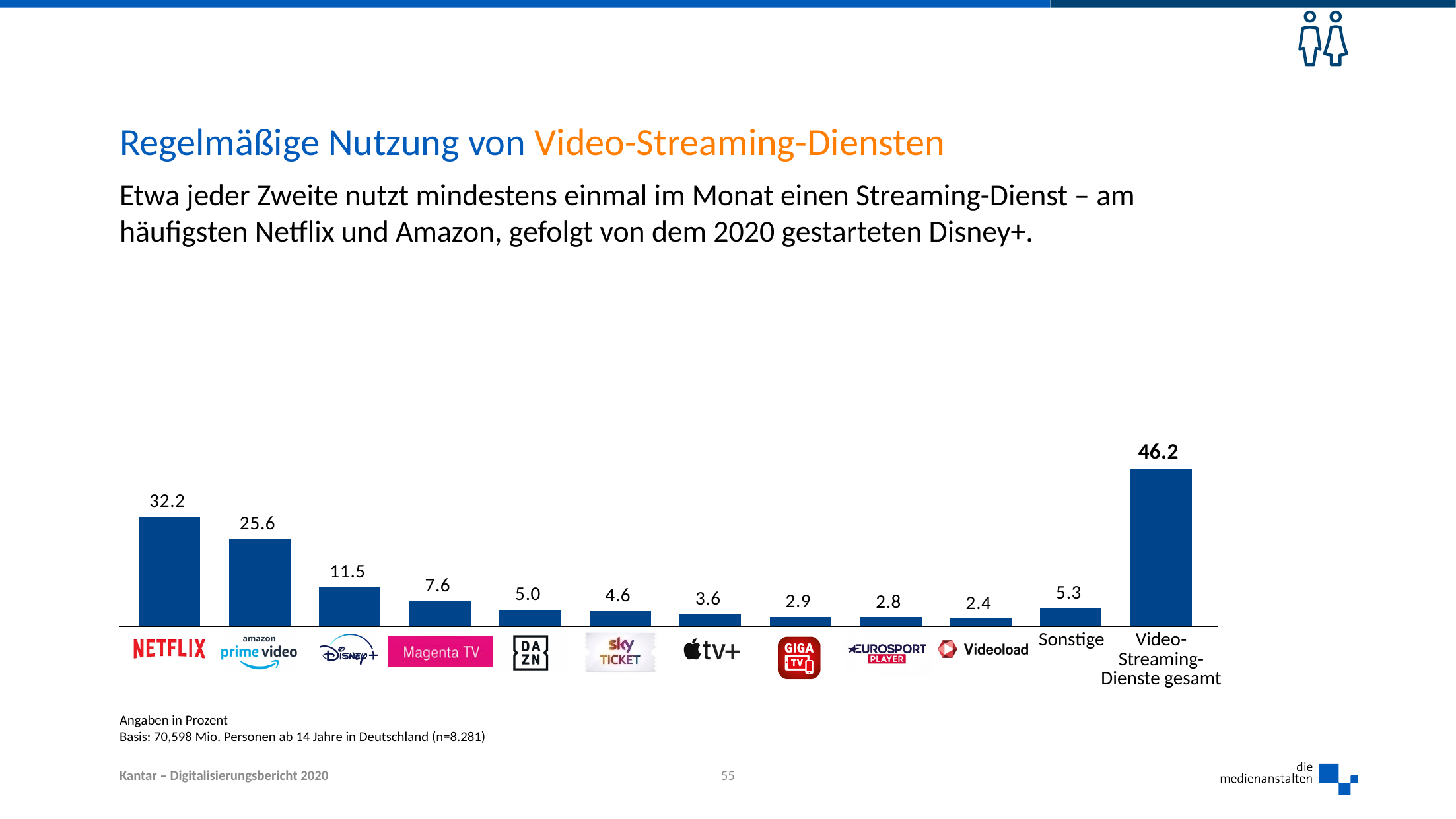
What kind of chart is shown on the slide? bar chart Which is larger, the value for DAZN or the value for Sky Ticket? DAZN How many bars are shown in the chart? 12 What is the difference between the values for Netflix and Amazon Prime Video? 6.6 Which category has the lowest value? Videoload What is the value for Sonstige? 5.3 In what unit are the values given, according to the note below the chart? Prozent Which category has the highest value? Video-Streaming-Dienste gesamt What is the value for Disney+? 11.5 What is the value for Video-Streaming-Dienste gesamt? 46.2 What is the value for Netflix? 32.2 What is the value for Magenta TV? 7.6